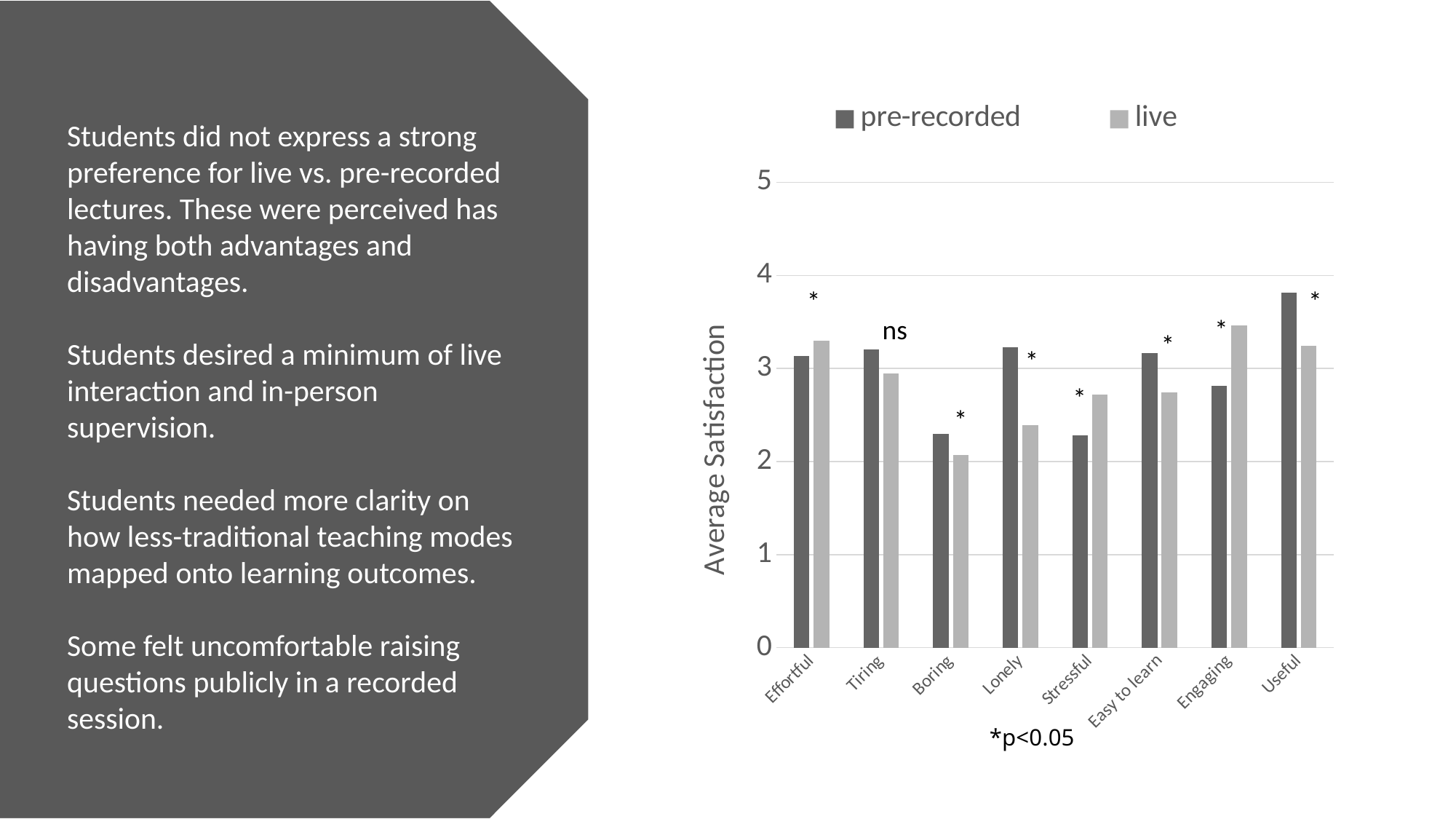
How many categories are shown on the x axis? 8 Is the live value for Lonely greater or less than 3? less Which category has the highest pre-recorded value? Useful How many series does the legend list? 2 Is the live value for Engaging greater or less than 3? greater Which category has the lowest live value? Boring Which category has the highest live value? Engaging For Engaging, which series has the larger value, pre-recorded or live? live For Lonely, which series has the larger value, pre-recorded or live? pre-recorded Is the pre-recorded value for Useful greater or less than 3? greater What is the label on the vertical axis? Average Satisfaction What kind of chart is shown on the slide? bar chart